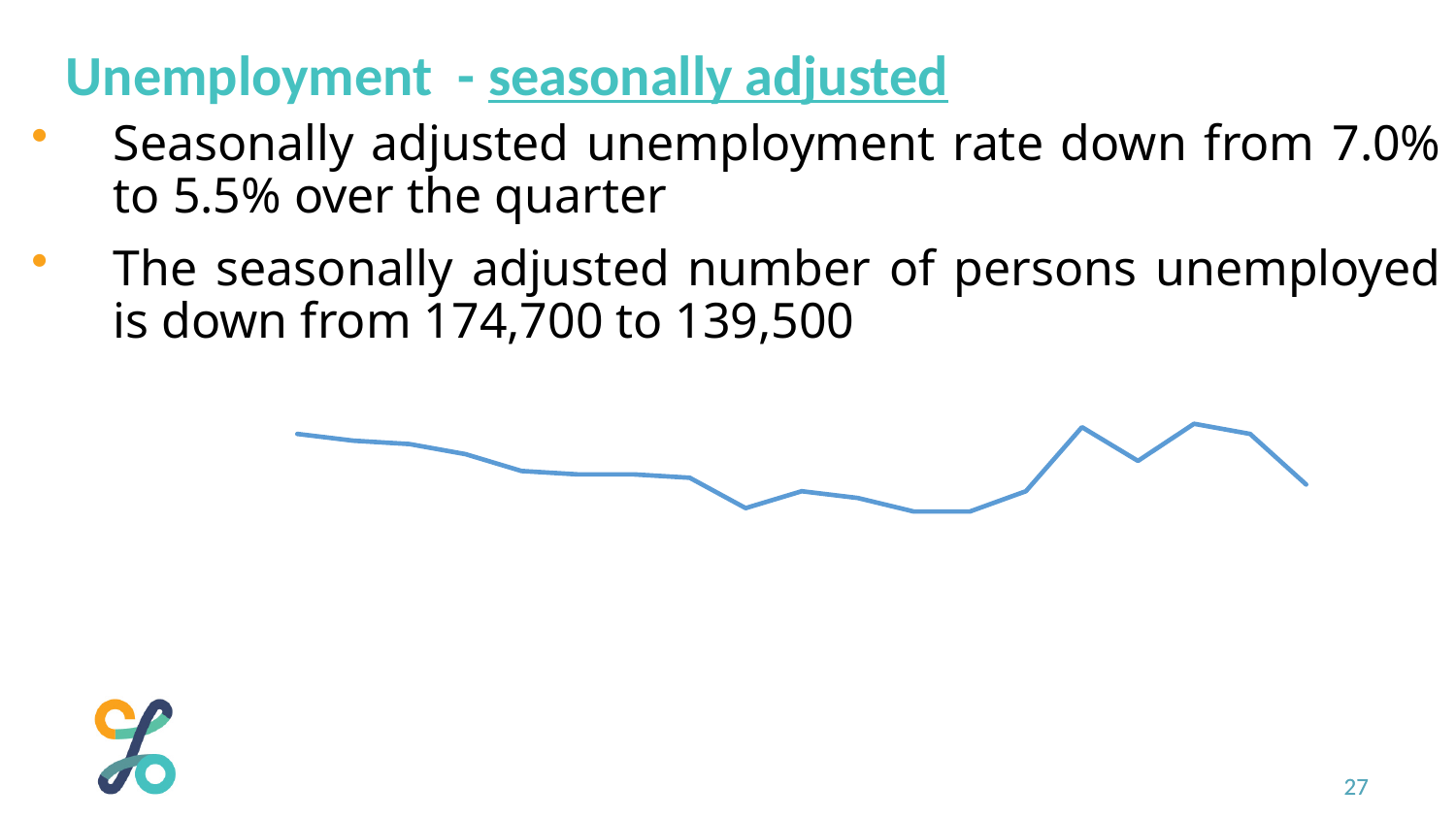
How many lines are plotted on the chart? 1 What kind of chart is shown on the slide? line chart Over the left half of the chart, does the line generally rise or fall? fall Does the chart display any axis labels or a legend? no Does the line end lower or higher than where it starts at the left of the chart? lower What colour is the line on the chart? blue